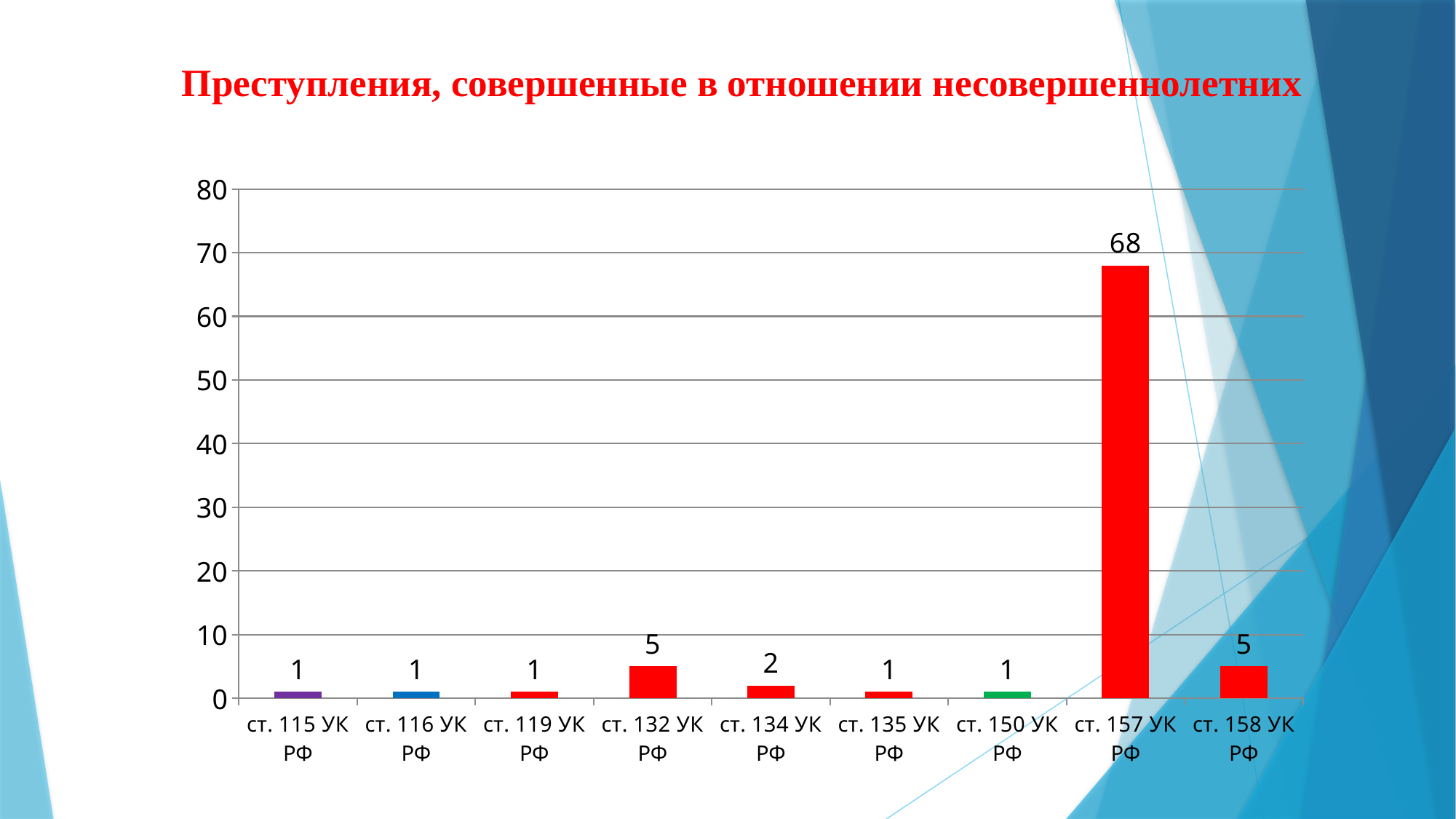
Which is larger, the value for ст. 134 УК РФ or the value for ст. 135 УК РФ? ст. 134 УК РФ What is the value for ст. 157 УК РФ? 68 What is the title of the chart? Преступления, совершенные в отношении несовершеннолетних What type of chart is shown on the slide? bar chart Which category has the highest value? ст. 157 УК РФ What is the value for ст. 158 УК РФ? 5 What is the value for ст. 134 УК РФ? 2 What is the difference between the values for ст. 132 УК РФ and ст. 134 УК РФ? 3 What is the value for ст. 115 УК РФ? 1 How many categories are shown on the x axis? 9 What is the difference between the values for ст. 157 УК РФ and ст. 158 УК РФ? 63 What is the value for ст. 132 УК РФ? 5